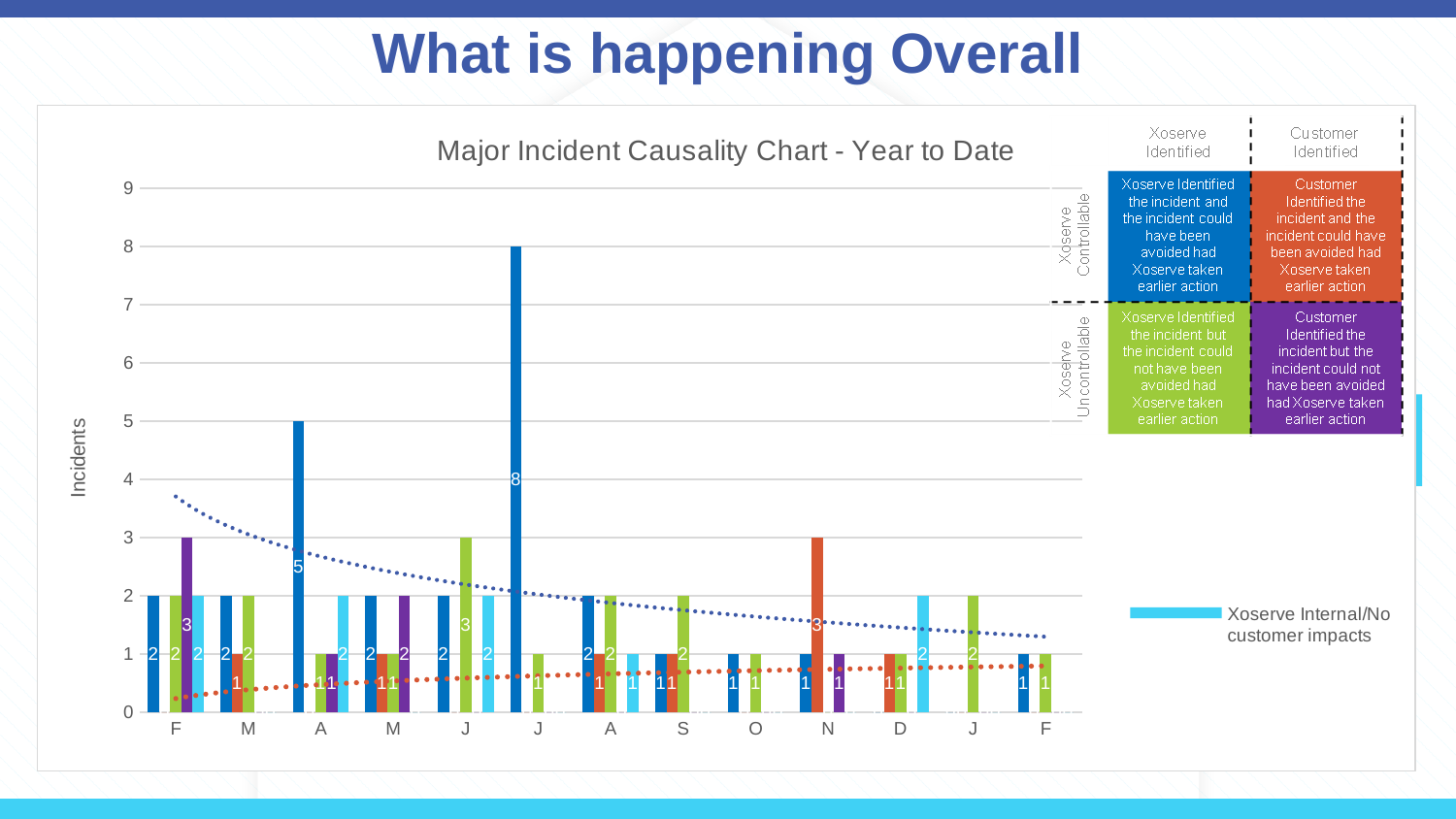
What is the label on the vertical axis of the chart? Incidents What is the value of the green bar in the first J month? 3 What is the value of the orange bar in the N month? 3 What is the value of the tallest bar in the second J month? 8 How many month categories are shown along the x axis of the chart? 13 What is the value of the tallest bar in the A (April) month? 5 Is the value of the tallest bar in the second J month greater or less than 6? greater What is the difference between the tallest bar in the second J month (8) and the tallest bar in the A month (5)? 3 Which is larger: the tallest bar in the A month or the tallest bar in the second J month? the second J month What type of chart is the Major Incident Causality Chart - Year to Date? bar chart What is the highest value shown by any bar in the chart? 8 What is the title of the chart on the slide? Major Incident Causality Chart - Year to Date